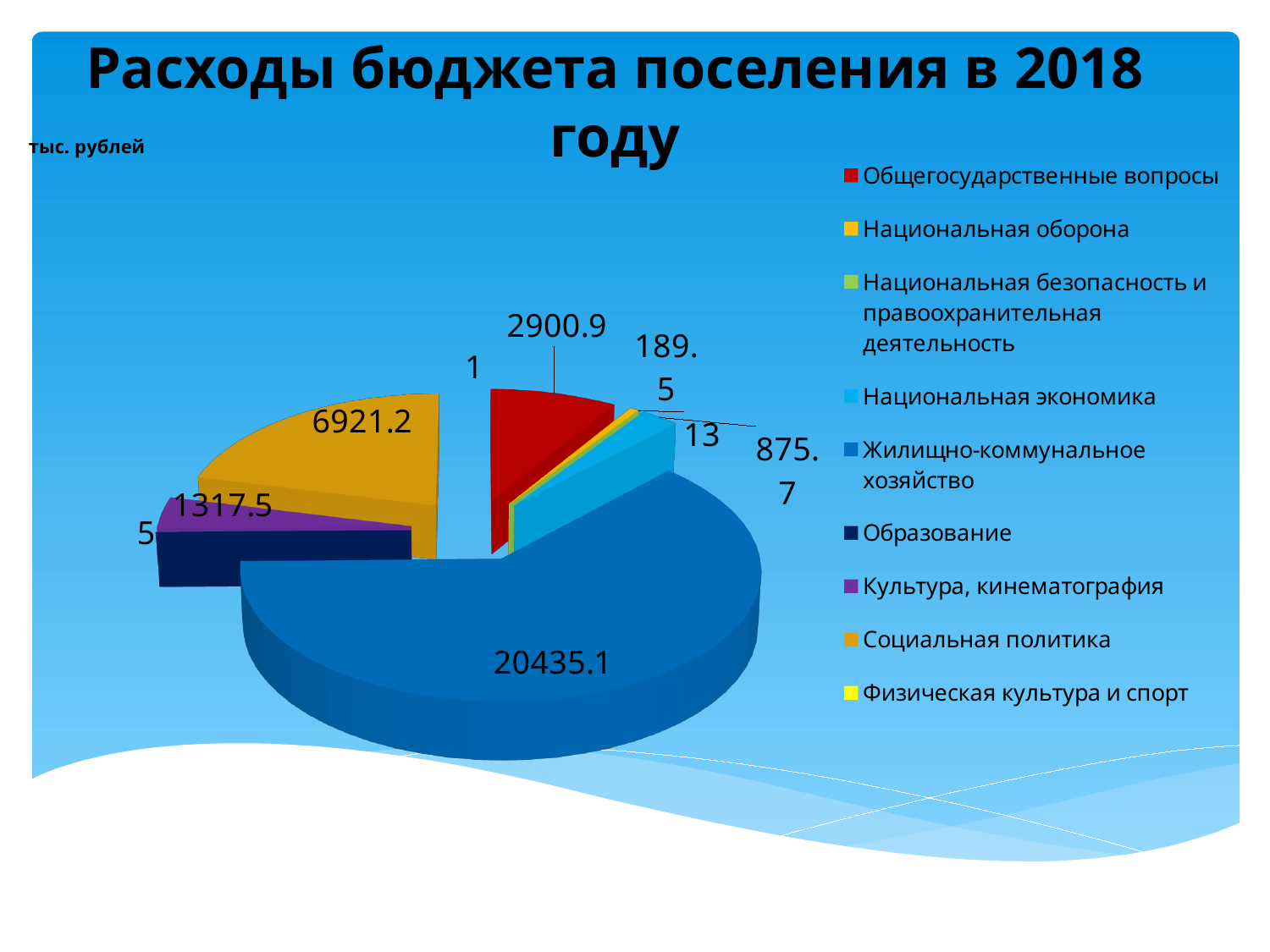
Which is larger: Жилищно-коммунальное хозяйство or Социальная политика? Жилищно-коммунальное хозяйство What is the difference between the values for Социальная политика and Общегосударственные вопросы? 4020.3 What is the title of the chart? тыс. рублей What is the value for Национальная экономика? 875.7 What is the value of the largest slice of the pie chart? 20435.1 What is the difference between the values for Общегосударственные вопросы and Культура, кинематография? 1583.4 Which category has the largest slice of the pie chart? Жилищно-коммунальное хозяйство What is the value for Культура, кинематография? 1317.5 What is the value for Социальная политика? 6921.2 How many categories does the legend of the pie chart list? 9 What is the value for Общегосударственные вопросы? 2900.9 What kind of chart is shown on the slide? pie chart